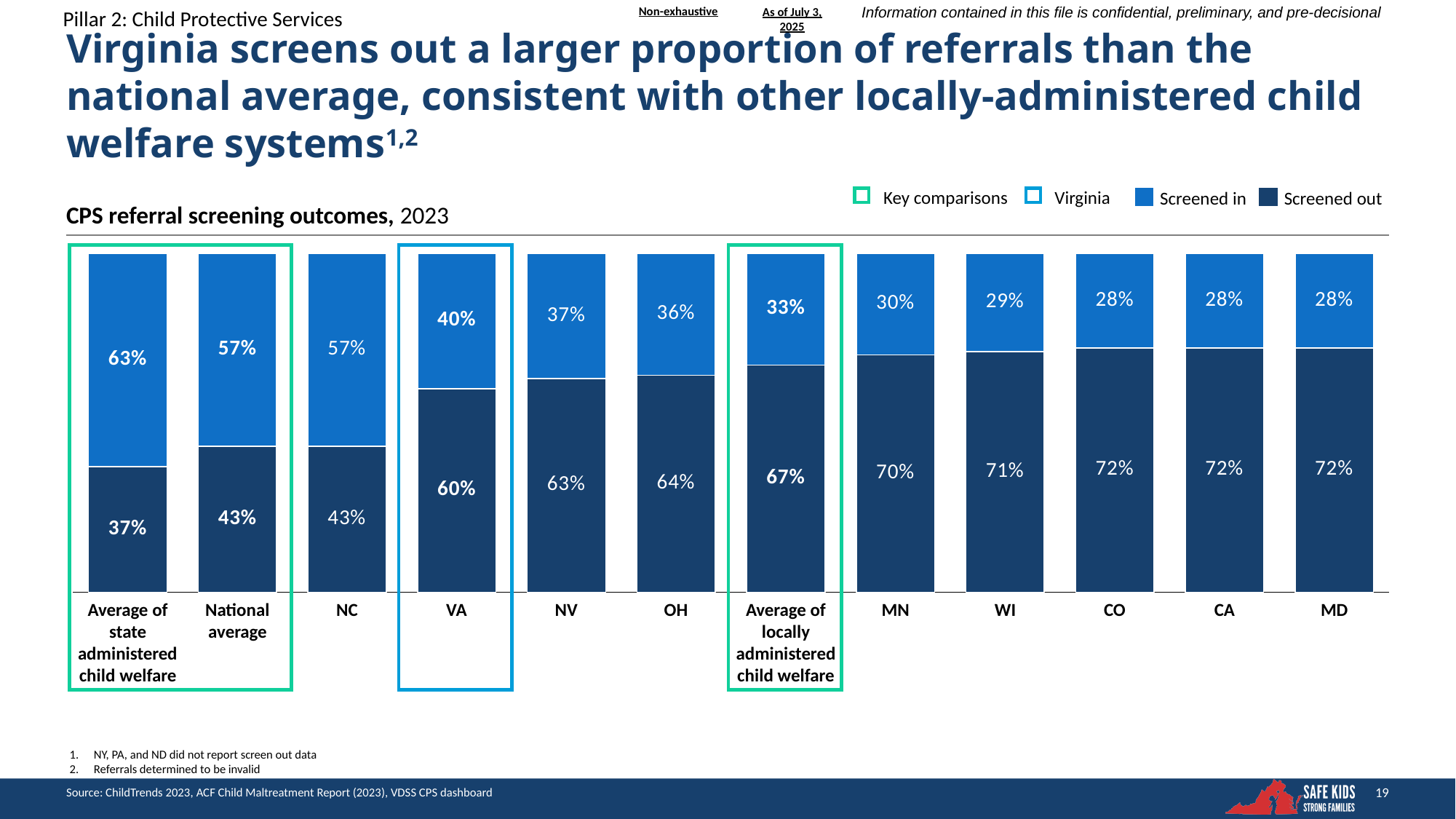
What is the title of the chart? CPS referral screening outcomes, 2023 How many categories are shown on the x axis of the chart? 12 What type of chart is shown on the slide? Stacked bar chart What is the total of the stacked bar for WI? 100% What percentage of referrals were screened in for the National average? 57% Which category has the lowest screened-out percentage? Average of state administered child welfare Which has a larger screened-out percentage, OH or NV? OH What is the screened-out percentage for the Average of locally administered child welfare? 67% What is the screened-in percentage for MN? 30% What is the difference between the screened-out percentage for VA and the National average? 17% What percentage of referrals were screened out in VA? 60% Which category has the highest screened-in percentage? Average of state administered child welfare